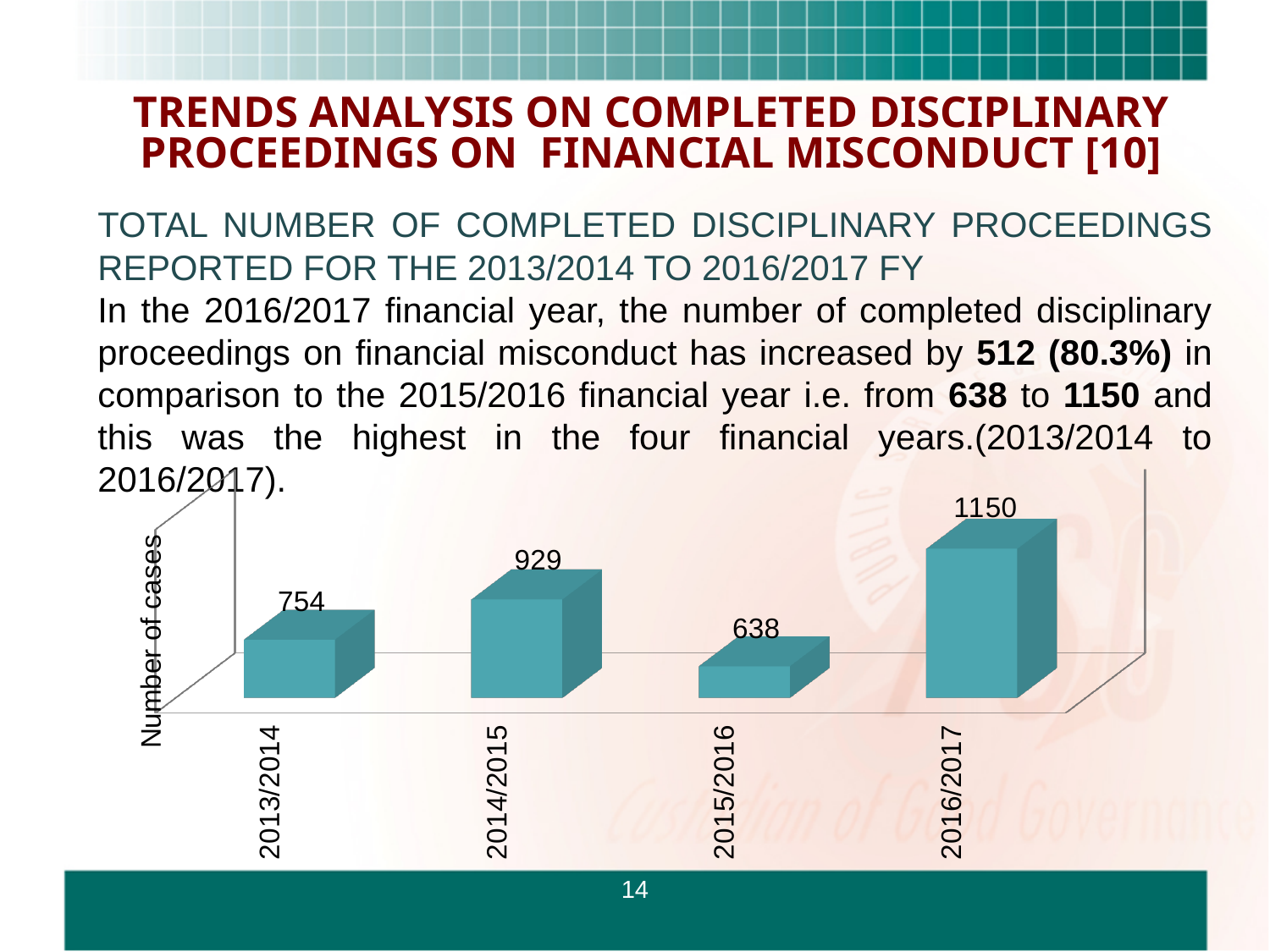
What kind of chart is shown on the slide? Bar chart What is the number of cases for 2014/2015? 929 Which financial year has the lowest number of cases? 2015/2016 What is the difference in the number of cases between 2016/2017 and 2015/2016? 512 What is the number of cases for 2015/2016? 638 Which has more cases, 2013/2014 or 2014/2015? 2014/2015 What is the label of the vertical axis of the chart? Number of cases What is the number of cases for 2016/2017? 1150 Which financial year has the highest number of cases? 2016/2017 What is the difference in the number of cases between 2014/2015 and 2013/2014? 175 What is the number of cases for 2013/2014? 754 How many financial years are shown in the chart? 4